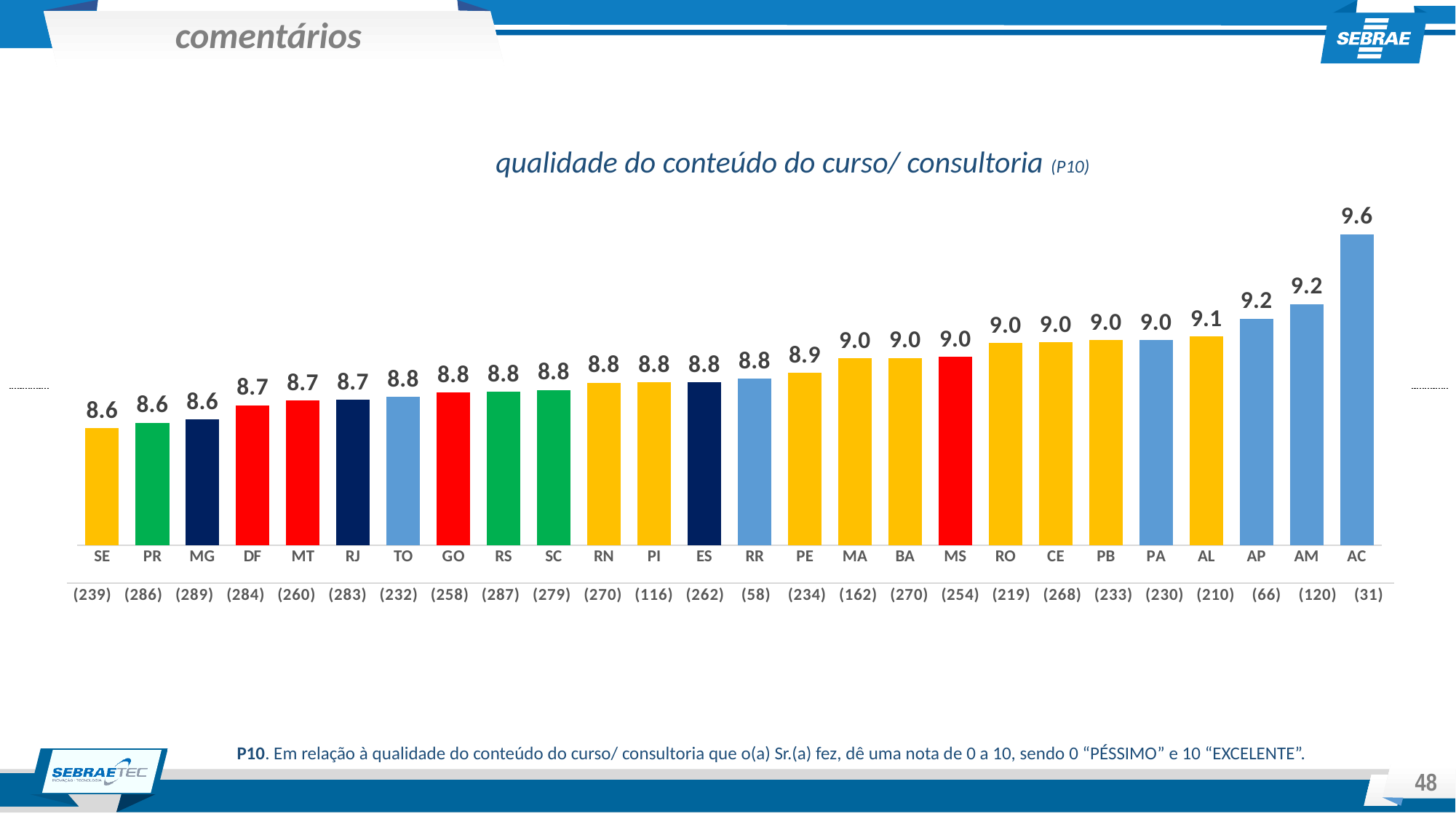
What is the difference between the values for AP and DF? 0.5 What is the value for MS? 9.0 Do the values rise or fall from left to right along the x axis? rise What is the difference between the values for AC and SE? 1.0 What kind of chart is shown on the slide? bar chart What is the value for PE? 8.9 What is the value for TO? 8.8 What is the value for AL? 9.1 Which category has the highest value? AC Which is larger, the value for AM or the value for MG? AM How many categories are shown on the x axis? 26 What is the value for AC? 9.6